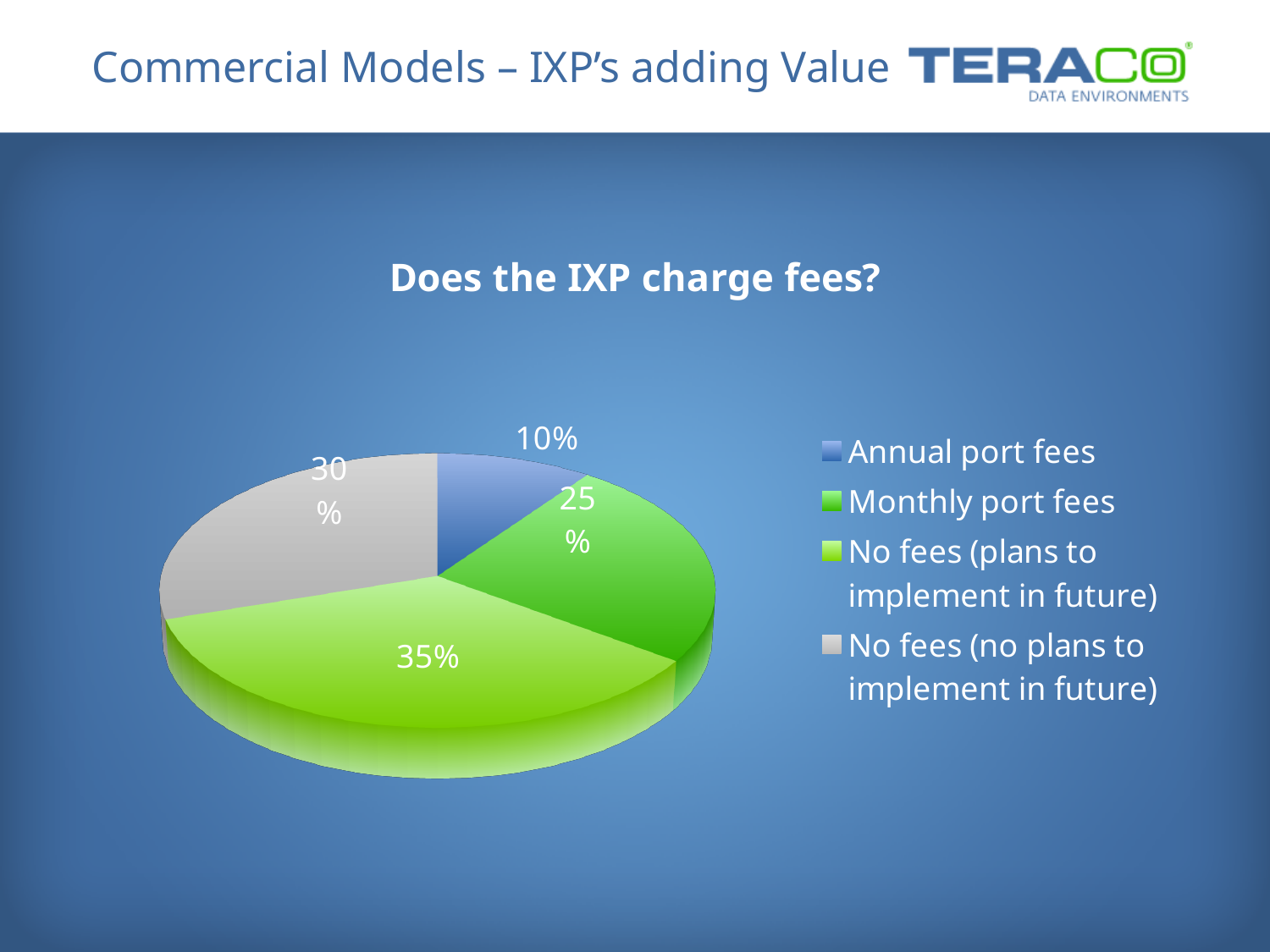
What colour is the 'Annual port fees' slice? blue Which is larger: 'Monthly port fees' or 'No fees (no plans to implement in future)'? No fees (no plans to implement in future) What percentage of the pie is 'Monthly port fees'? 25% What percentage of the pie is 'No fees (no plans to implement in future)'? 30% Which category has the smallest share of the pie? Annual port fees What kind of chart is shown on the slide? pie chart How many categories does the pie chart have? 4 What is the difference in percentage points between 'No fees (plans to implement in future)' and 'Monthly port fees'? 10 What percentage of the pie is 'No fees (plans to implement in future)'? 35% What percentage of the pie is 'Annual port fees'? 10% What is the title of the chart? Does the IXP charge fees? Which category has the largest share of the pie? No fees (plans to implement in future)